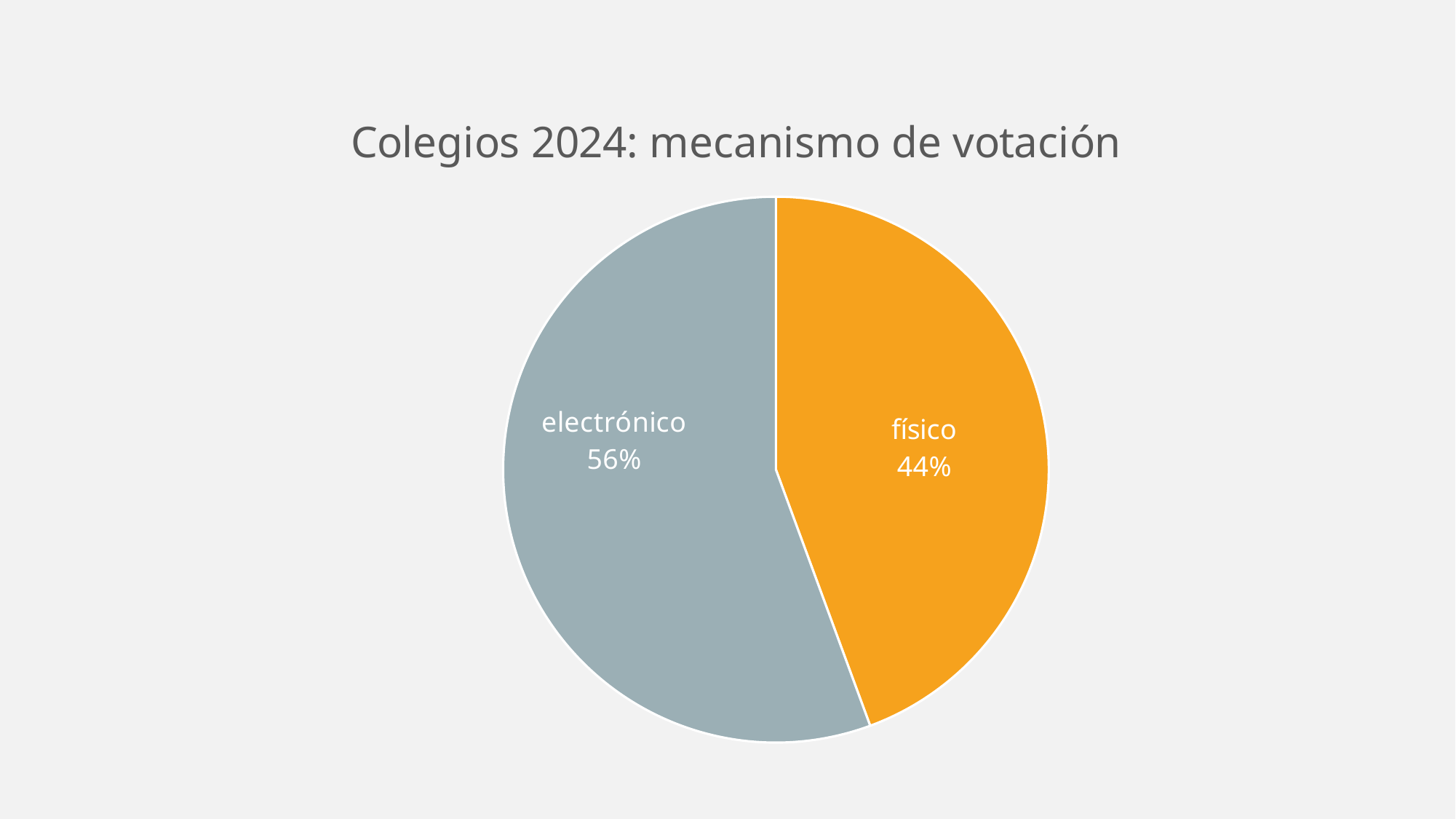
What kind of chart is shown on the slide? pie chart What share of the pie does the 'electrónico' slice represent? 56% Which category has the largest slice of the pie? electrónico What colour is the 'físico' slice? orange How many slices does the pie chart have? 2 What share of the pie does the 'físico' slice represent? 44% Which category has the smallest slice of the pie? físico Is the share for 'electrónico' greater or less than 50%? greater What is the title of the chart? Colegios 2024: mecanismo de votación What is the difference in percentage points between the 'electrónico' and 'físico' slices? 12 Is the share for 'físico' greater or less than 50%? less Which is larger, the 'electrónico' slice or the 'físico' slice? electrónico